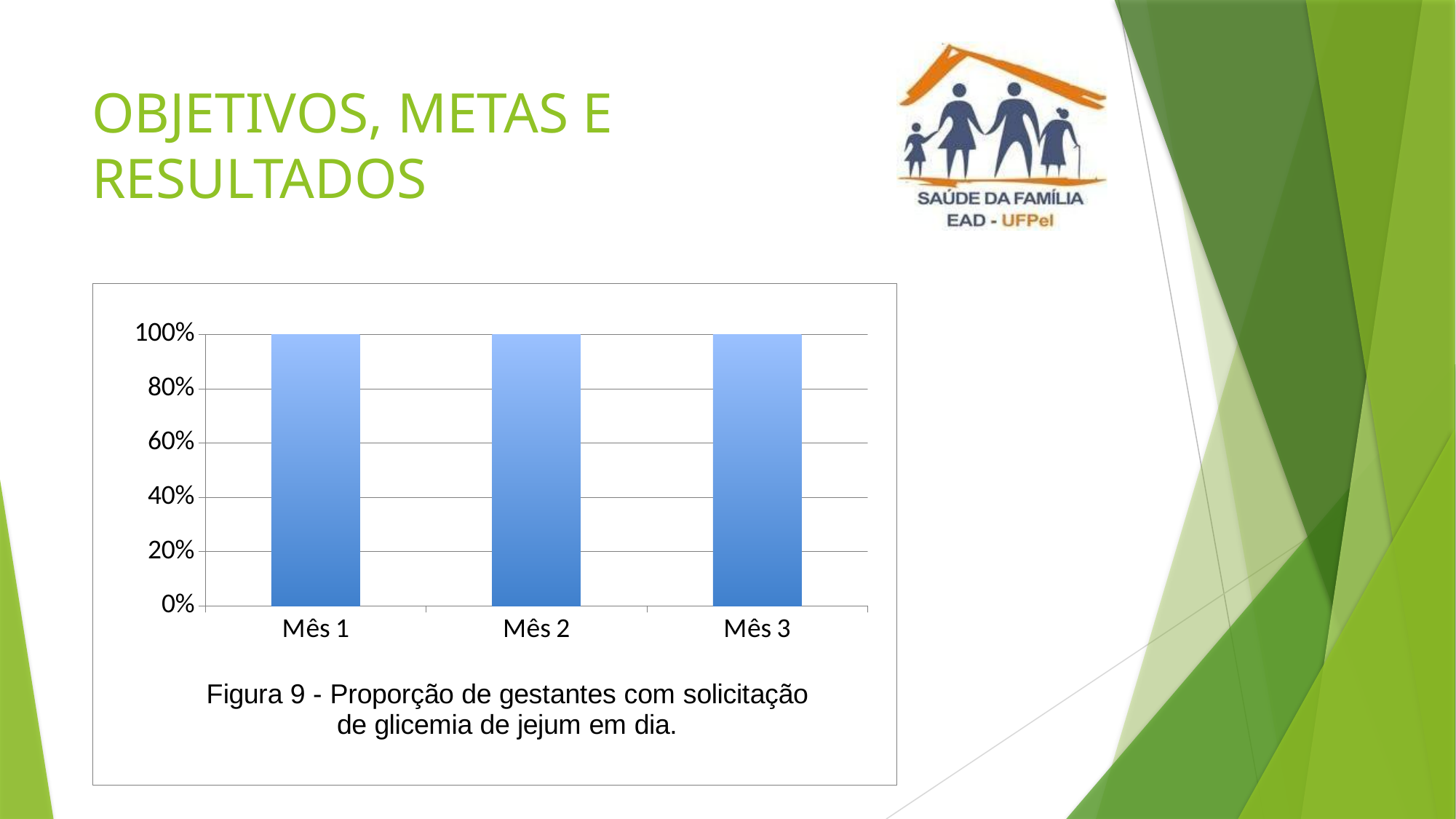
What is the highest value shown on the y axis of the chart? 100% What is the caption (figure title) of the chart? Figura 9 - Proporção de gestantes com solicitação de glicemia de jejum em dia. What is the value for Mês 3 in the chart? 100% What is the value for Mês 2 in the chart? 100% Is the value for Mês 1 greater or less than 80%? greater What is the difference between the values for Mês 1 and Mês 3? 0% What type of chart is shown on the slide? bar chart Is the value for Mês 3 greater or less than 60%? greater How many categories (months) are shown on the x axis of the chart? 3 Do the values rise, fall, or stay the same from Mês 1 to Mês 3? stay the same What is the value for Mês 1 in the chart? 100%